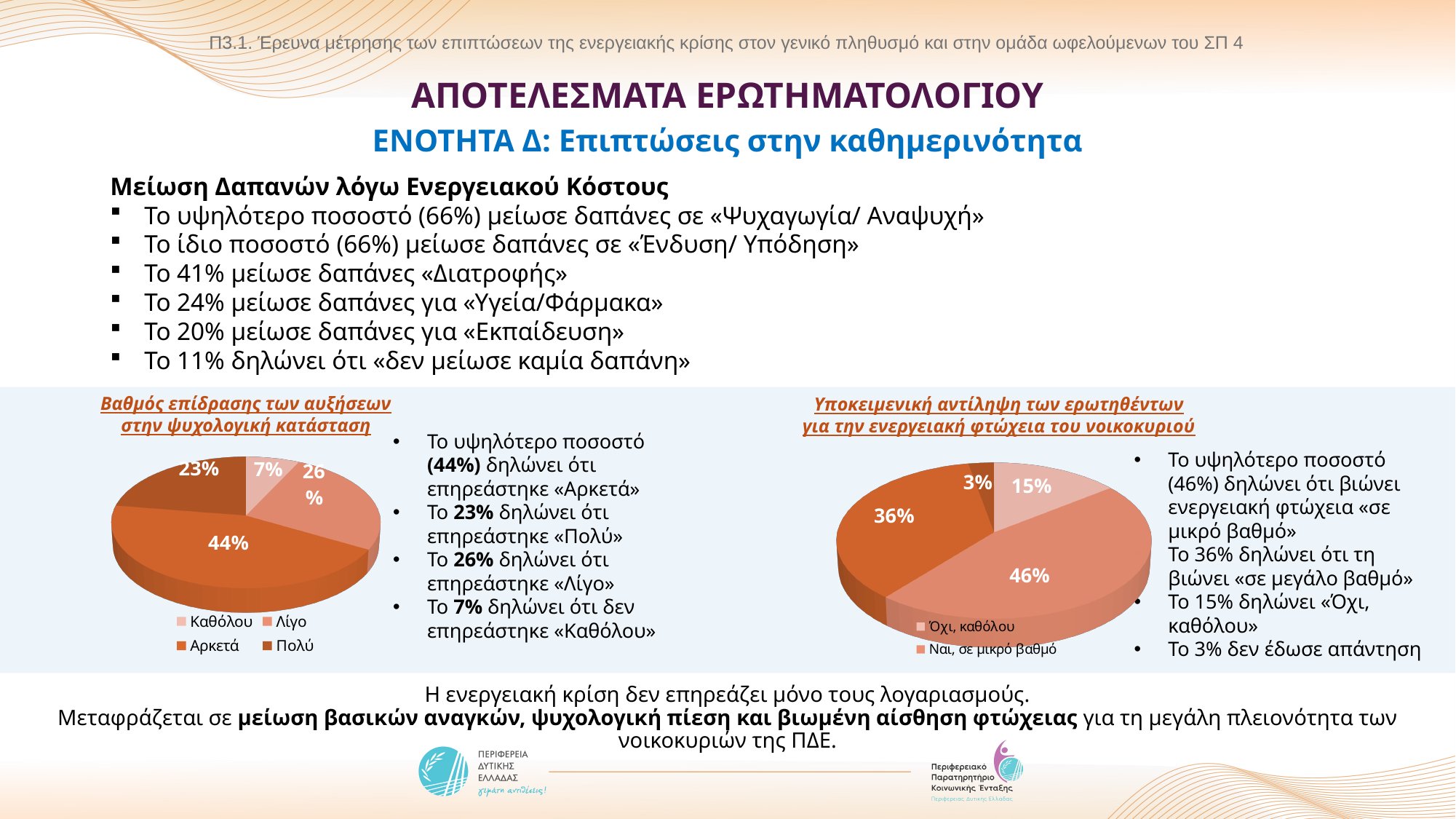
In the left pie chart (Βαθμός επίδρασης των αυξήσεων στην ψυχολογική κατάσταση), what percentage is shown for «Πολύ»? 23% In the left pie chart (Βαθμός επίδρασης των αυξήσεων στην ψυχολογική κατάσταση), what percentage is shown for «Αρκετά»? 44% In the left pie chart (Βαθμός επίδρασης των αυξήσεων στην ψυχολογική κατάσταση), which category has the largest slice? Αρκετά In the right pie chart (Υποκειμενική αντίληψη των ερωτηθέντων για την ενεργειακή φτώχεια του νοικοκυριού), which is larger: «Ναι, σε μικρό βαθμό» or «Όχι, καθόλου»? Ναι, σε μικρό βαθμό In the left pie chart (Βαθμός επίδρασης των αυξήσεων στην ψυχολογική κατάσταση), what percentage is shown for «Καθόλου»? 7% In the left pie chart (Βαθμός επίδρασης των αυξήσεων στην ψυχολογική κατάσταση), which category has the smallest slice? Καθόλου In the right pie chart (Υποκειμενική αντίληψη των ερωτηθέντων για την ενεργειακή φτώχεια του νοικοκυριού), what percentage is shown for «Όχι, καθόλου»? 15% In the right pie chart (Υποκειμενική αντίληψη των ερωτηθέντων για την ενεργειακή φτώχεια του νοικοκυριού), what percentage is shown for «Ναι, σε μικρό βαθμό»? 46% In the left pie chart (Βαθμός επίδρασης των αυξήσεων στην ψυχολογική κατάσταση), what is the difference in percentage points between «Αρκετά» and «Λίγο»? 18 How many slices does the right pie chart (Υποκειμενική αντίληψη των ερωτηθέντων για την ενεργειακή φτώχεια του νοικοκυριού) have? 4 How many entries does the legend of the left pie chart (Βαθμός επίδρασης των αυξήσεων στην ψυχολογική κατάσταση) list? 4 What type of chart is used for «Υποκειμενική αντίληψη των ερωτηθέντων για την ενεργειακή φτώχεια του νοικοκυριού»? Pie chart